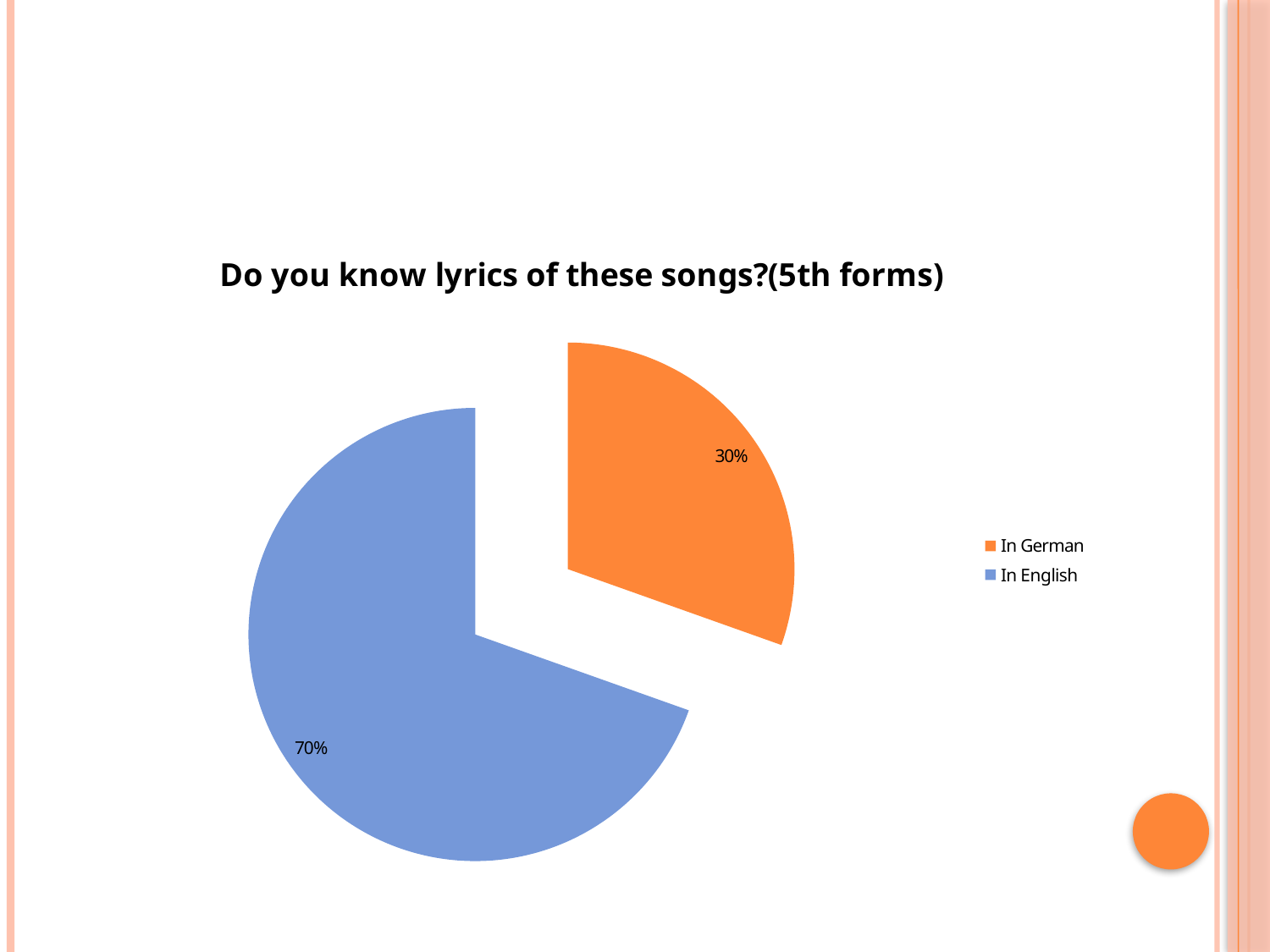
Which category has the largest share of the pie? In English What is the title of the chart? Do you know lyrics of these songs?(5th forms) What kind of chart is shown on the slide? pie chart What percentage of the pie is labelled for In German? 30% How many slices does the pie chart have? 2 What colour is the In German slice? orange What is the difference in percentage points between the In English and In German slices? 40 What is the share of the pie taken by the In German slice? 30% How many entries does the legend list? 2 Which is larger, the share for In German or the share for In English? In English What percentage of the pie is labelled for In English? 70% Which category has the smallest share of the pie? In German